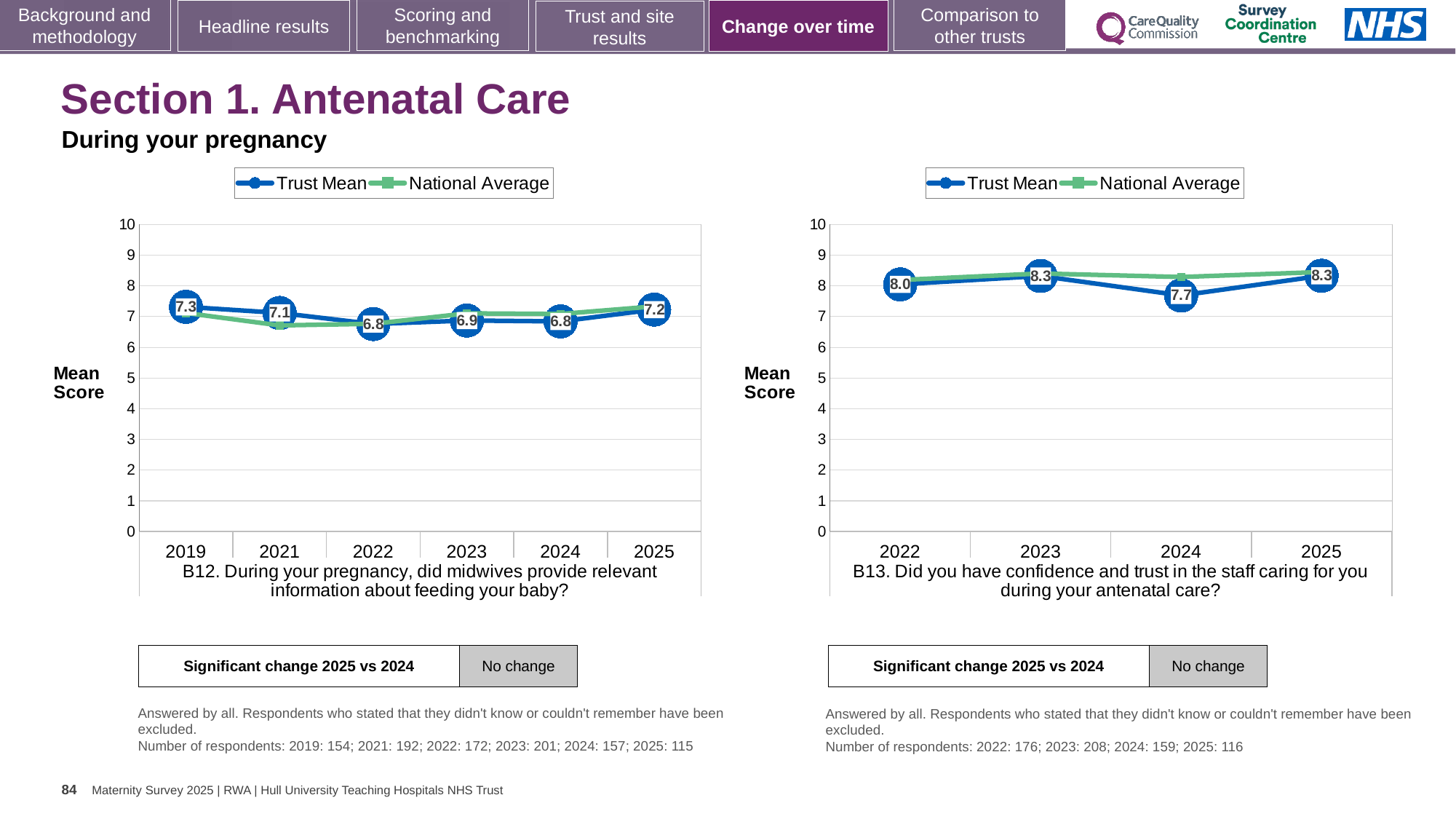
In the B12 chart on the left, which year has the highest Trust Mean score? 2019 In the B13 chart on the right, is the National Average value for 2024 greater or less than 8? greater In the B12 chart on the left, what is the Trust Mean score for 2019? 7.3 In the B12 chart on the left, what is the difference between the Trust Mean scores for 2019 and 2022? 0.5 In the B13 chart on the right, what is the difference between the Trust Mean scores for 2023 and 2024? 0.6 In the B12 chart on the left, what is the Trust Mean score for 2025? 7.2 In the B13 chart on the right, what is the Trust Mean score for 2024? 7.7 What kind of chart is the B12 chart on the left? Line chart How many series does the legend of the B13 chart on the right list? 2 In the B13 chart on the right, which year has the lowest Trust Mean score? 2024 How many years are plotted on the x axis of the B12 chart on the left? 6 In the B13 chart on the right, is the Trust Mean score higher in 2022 or in 2023? 2023